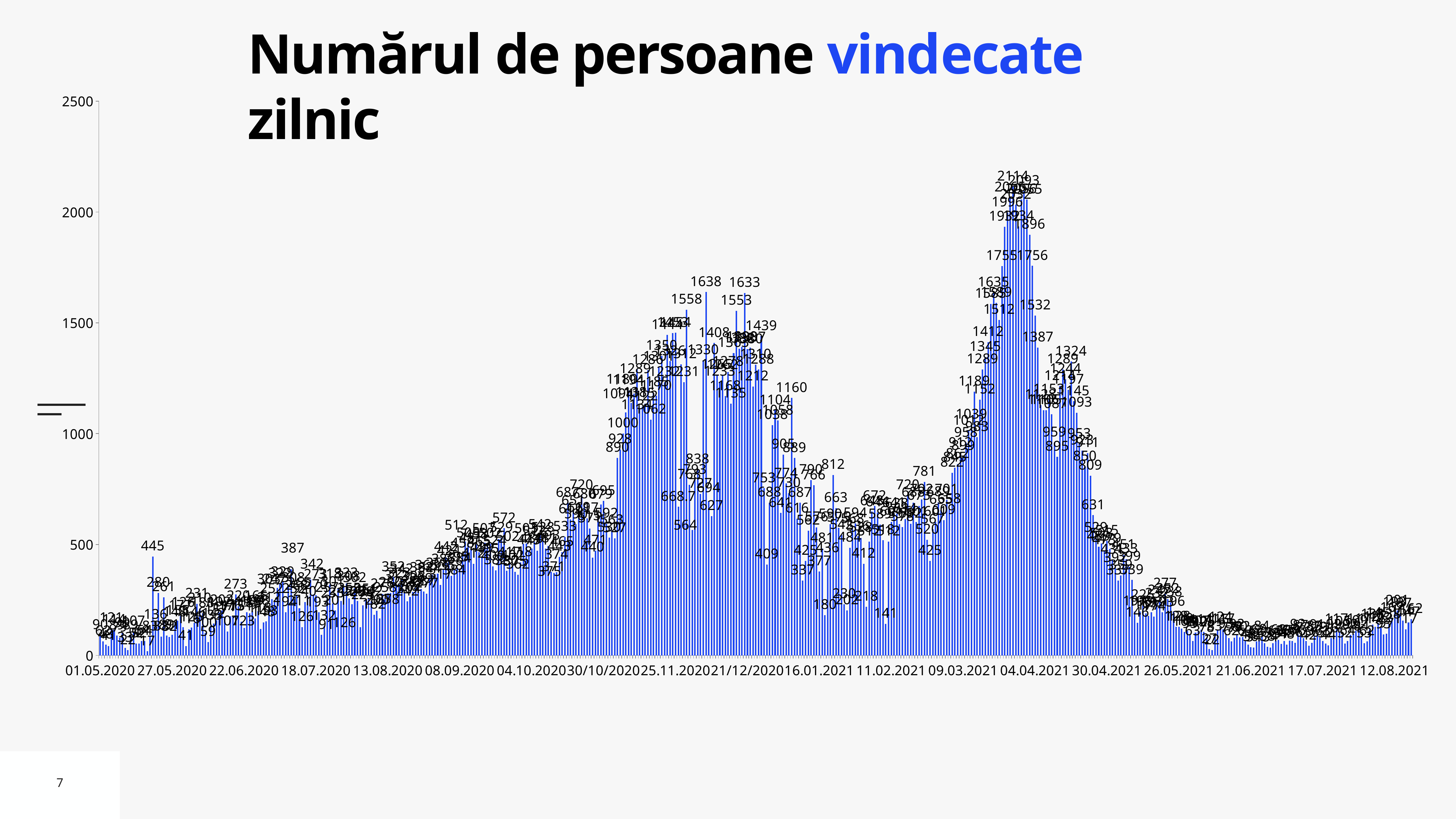
What is the title of the chart? Numărul de persoane vindecate zilnic What is the highest daily value labelled on the chart? 2114 Are the bars around 21.06.2021 greater or less than 500? less What is the difference between the peak value 2114 and the labelled value 1896 in April 2021? 218 Which is larger, the labelled value 445 near 27.05.2020 or the labelled value 387 near 18.07.2020? 445 What is the difference between the labelled values 1638 and 1633 in the November–December 2020 peak? 5 What is the highest value labelled in the peak around 25.11.2020? 1638 What kind of chart is shown on the slide? bar chart Is the highest bar around 04.04.2021 greater or less than 2000? greater What is the maximum value shown on the vertical axis? 2500 Do the values rise or fall between 04.04.2021 and 26.05.2021? fall Which is larger, the peak value of 2114 in April 2021 or the peak value of 1638 in November 2020? 2114